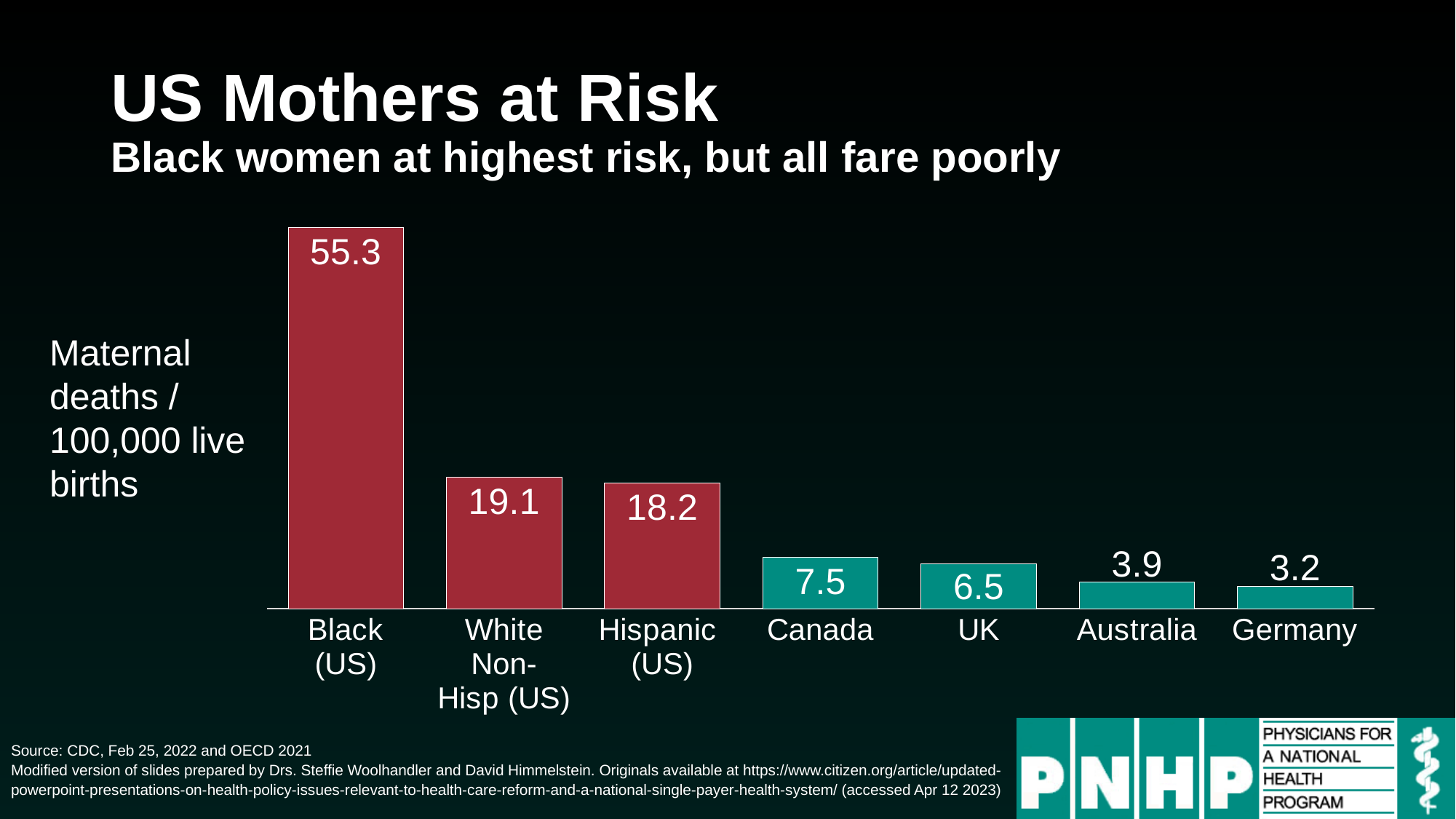
What is the value shown for Canada? 7.5 Which category has the lowest maternal death rate? Germany What is the difference between the values for Black (US) and White Non-Hisp (US)? 36.2 What is the value shown for White Non-Hisp (US)? 19.1 What kind of chart is shown on the slide? Bar chart Which is larger, the value for Hispanic (US) or the value for Canada? Hispanic (US) Which category has the highest maternal death rate? Black (US) What is the maternal deaths per 100,000 live births value for Black (US)? 55.3 What unit is the chart's vertical axis measured in, according to the label on the left? Maternal deaths / 100,000 live births What is the difference between the values for Canada and UK? 1.0 What is the value shown for Germany? 3.2 How many categories are shown in the chart? 7